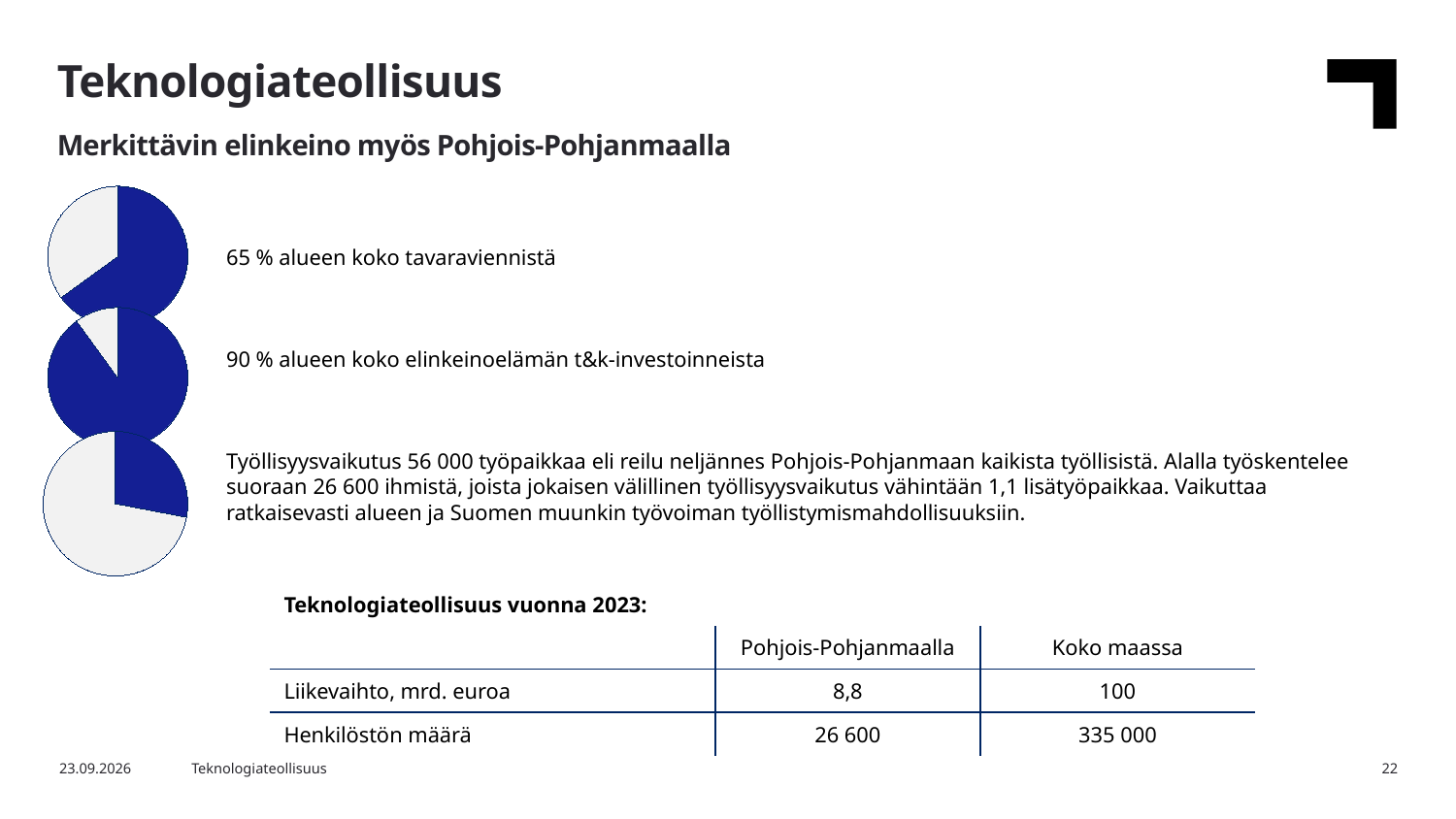
What is the difference between the shares shown by the middle pie chart (90 %) and the top pie chart (65 %)? 25 percentage points Is the blue slice larger in the top pie chart or in the bottom pie chart? The top pie chart What colour is the highlighted slice in each pie chart? Blue Which of the three pie charts has the largest blue slice? The middle pie chart What kind of charts are shown on the left side of the slide? Pie charts Is the blue slice larger in the top pie chart or in the middle pie chart? The middle pie chart In the top pie chart, what share of the region's total goods exports does the blue slice represent? 65 % How many slices does each pie chart have? 2 In the middle pie chart, what share of the region's business R&D investments does the blue slice represent? 90 % How many pie charts are on the slide? 3 Which of the three pie charts has the smallest blue slice? The bottom pie chart